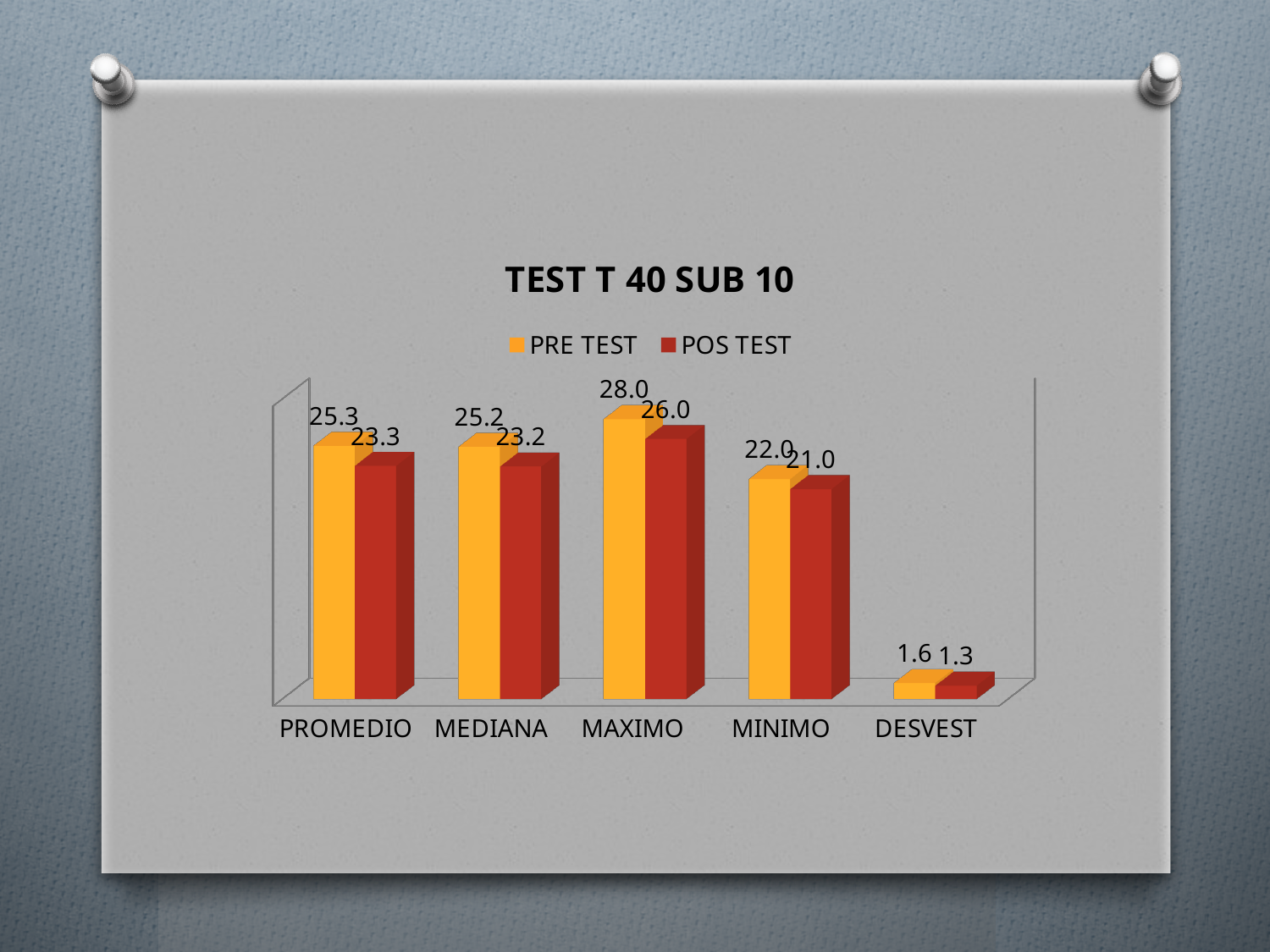
What is the PRE TEST value for MINIMO? 22.0 How many categories are shown on the x axis? 5 What is the POS TEST value for MAXIMO? 26.0 What is the PRE TEST value for PROMEDIO? 25.3 What is the title of the chart? TEST T 40 SUB 10 What is the POS TEST value for DESVEST? 1.3 Which category has the lowest POS TEST value? DESVEST What is the difference between the PRE TEST and POS TEST values for MEDIANA? 2.0 Which is larger for MINIMO, the PRE TEST value or the POS TEST value? PRE TEST How many series does the legend list? 2 What kind of chart is shown on the slide? Bar chart Which category has the highest PRE TEST value? MAXIMO